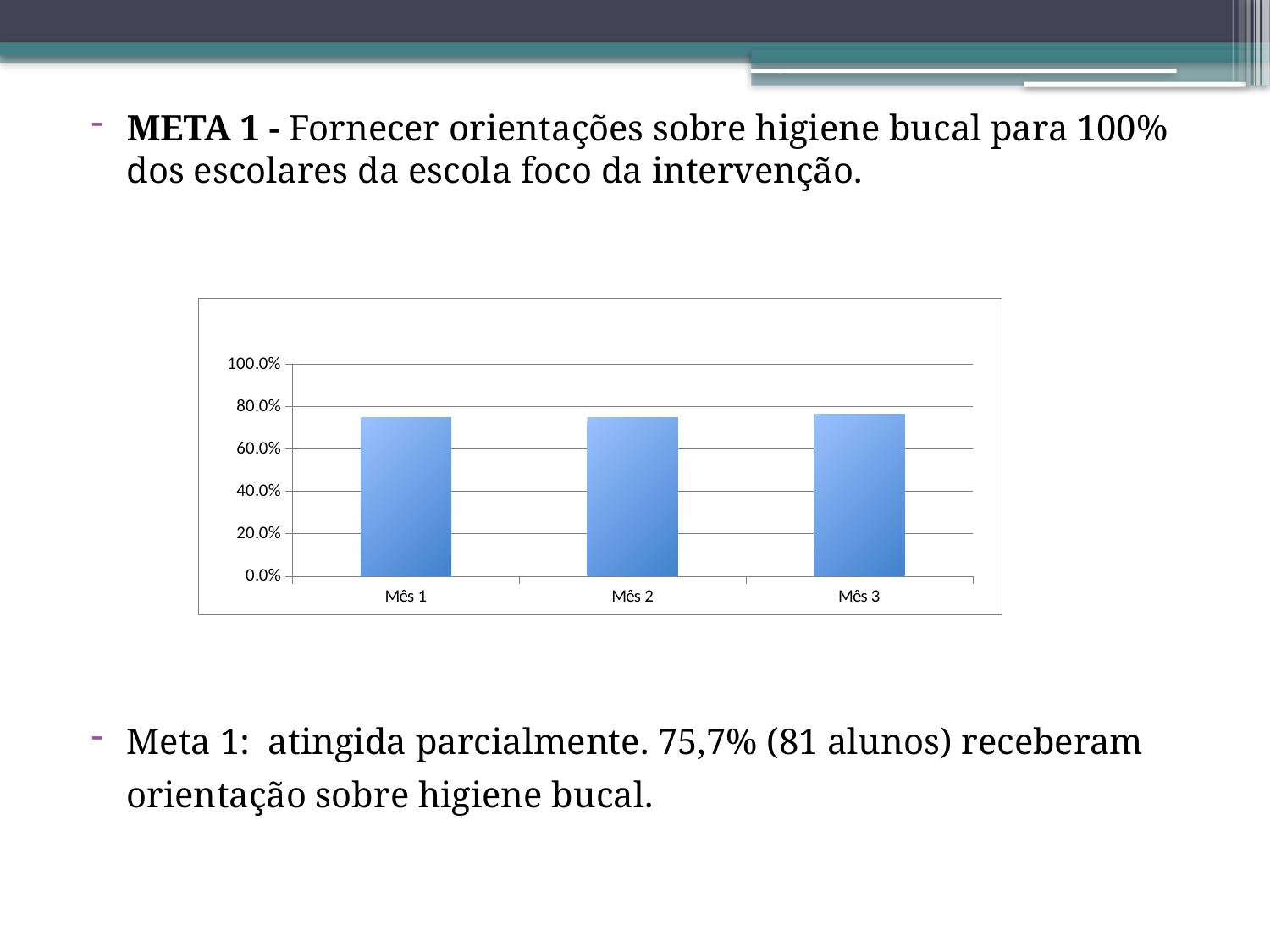
Is the value for Mês 2 greater or less than 20.0%? greater Is the value for Mês 1 greater or less than 60.0%? greater How many categories are shown on the x axis of the chart? 3 Is the value for Mês 3 greater or less than 100.0%? less What is the highest tick value shown on the y axis of the chart? 100.0% What kind of chart is shown on the slide? bar chart What is the label of the first category on the x axis of the chart? Mês 1